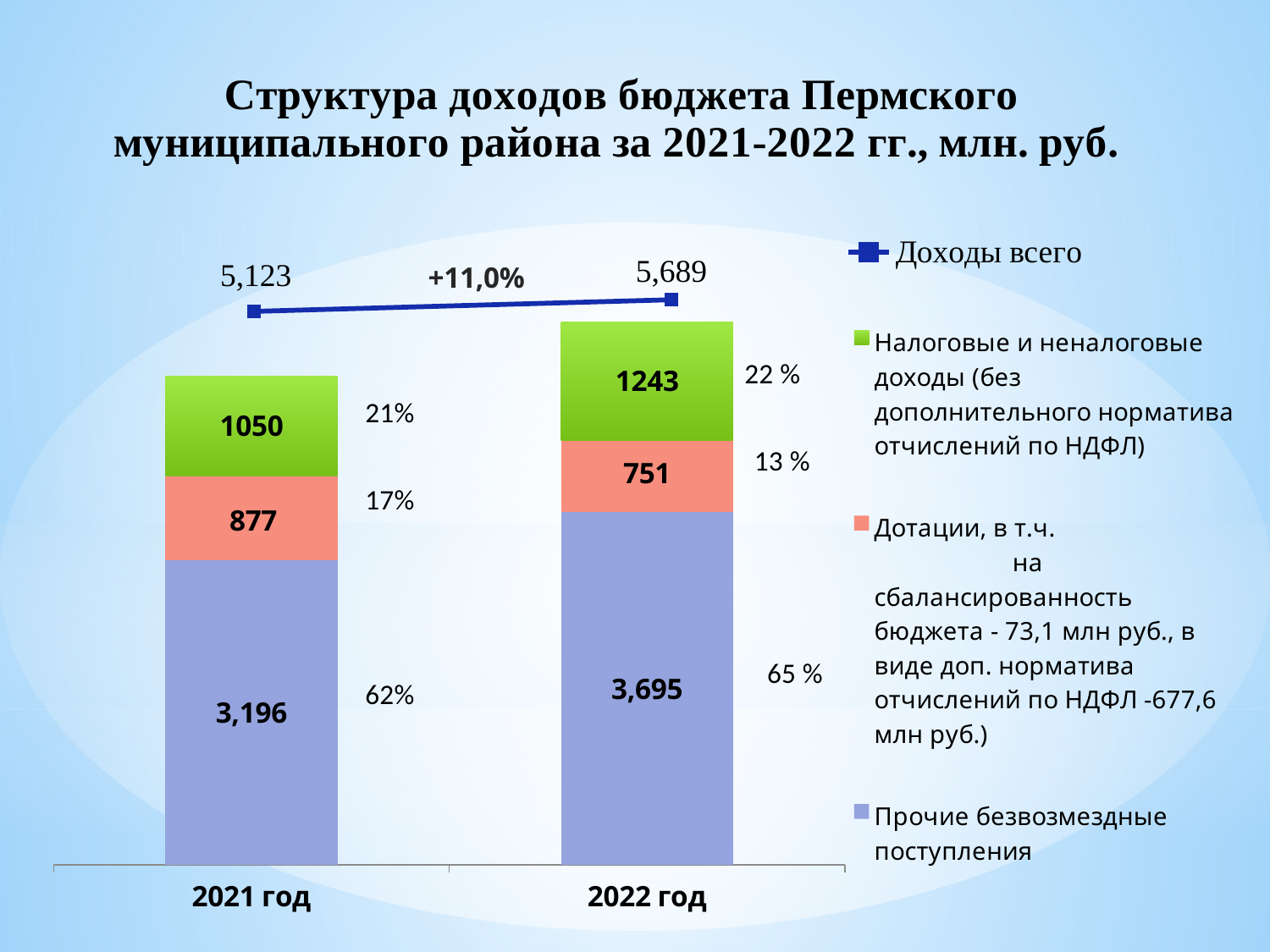
How many entries does the legend list? 4 What is the Доходы всего value for 2022 год? 5,689 Which year has the higher Доходы всего value? 2022 год Is the Налоговые и неналоговые доходы value larger in 2021 год or 2022 год? 2022 год What is the value of Прочие безвозмездные поступления for 2021 год? 3,196 What is the difference between the Дотации values for 2021 год and 2022 год? 126 What is the value of Налоговые и неналоговые доходы for 2022 год? 1243 How many year categories are shown on the x axis? 2 What percentage change in Доходы всего is labelled between 2021 год and 2022 год? +11,0% Which segment is the smallest in the 2022 год bar? Дотации What percentage share is shown for Прочие безвозмездные поступления in 2022 год? 65 % What is the value of Дотации for 2021 год? 877